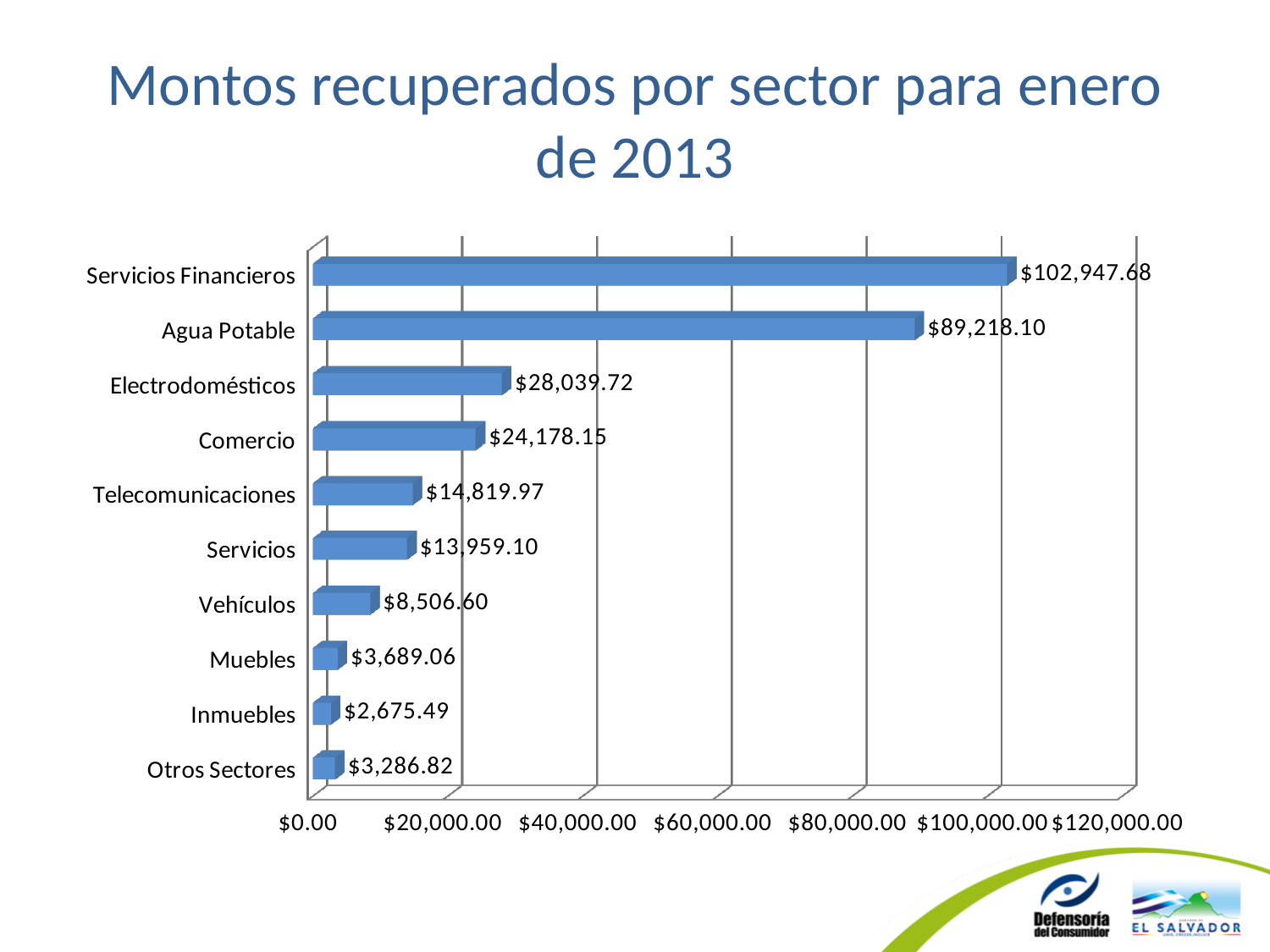
Which sector has the highest recovered amount? Servicios Financieros What is the title of the chart? Montos recuperados por sector para enero de 2013 What is the value for Servicios Financieros? $102,947.68 What is the difference between the values for Servicios Financieros and Agua Potable? $13,729.58 What is the value for Inmuebles? $2,675.49 What kind of chart is shown on the slide? Bar chart How many sectors are shown in the chart? 10 Which sector has the lowest recovered amount? Inmuebles What is the value for Telecomunicaciones? $14,819.97 Which is larger, the value for Muebles or the value for Otros Sectores? Muebles Is the value for Vehículos greater or less than $20,000.00? less What is the difference between the values for Electrodomésticos and Comercio? $3,861.57